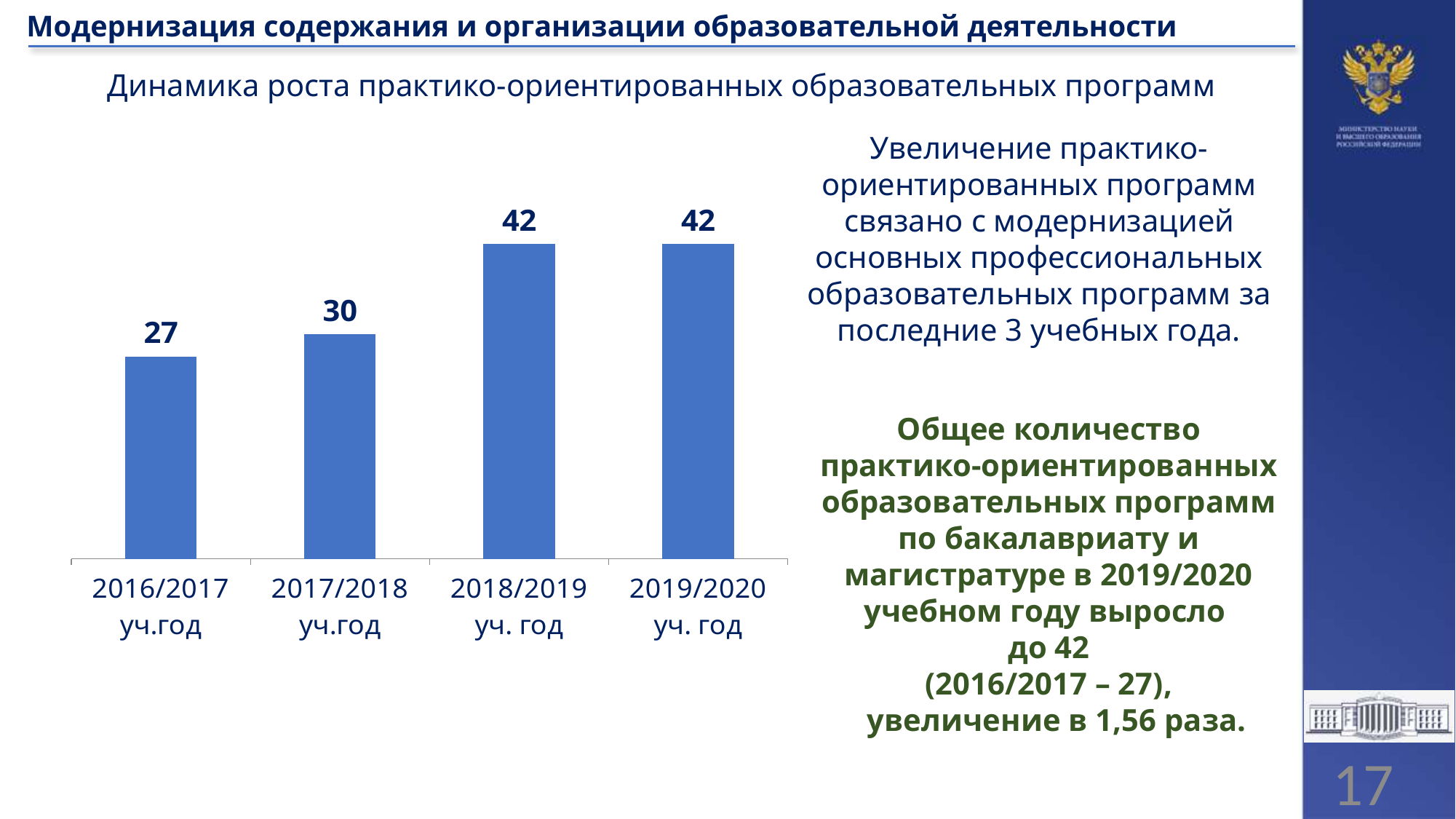
Which academic year has the lowest value? 2016/2017 уч.год What is the value for 2016/2017 уч.год? 27 What is the title of the chart? Динамика роста практико-ориентированных образовательных программ What kind of chart is shown on the slide? bar chart Which is larger, the value for 2017/2018 уч.год or the value for 2016/2017 уч.год? 2017/2018 уч.год What is the difference between the values for 2019/2020 уч. год and 2016/2017 уч.год? 15 What is the value for 2018/2019 уч. год? 42 What is the value for 2019/2020 уч. год? 42 How many academic years are shown on the chart? 4 What is the difference between the values for 2018/2019 уч. год and 2017/2018 уч.год? 12 What is the value for 2017/2018 уч.год? 30 Do the values rise or fall from 2016/2017 to 2018/2019? rise